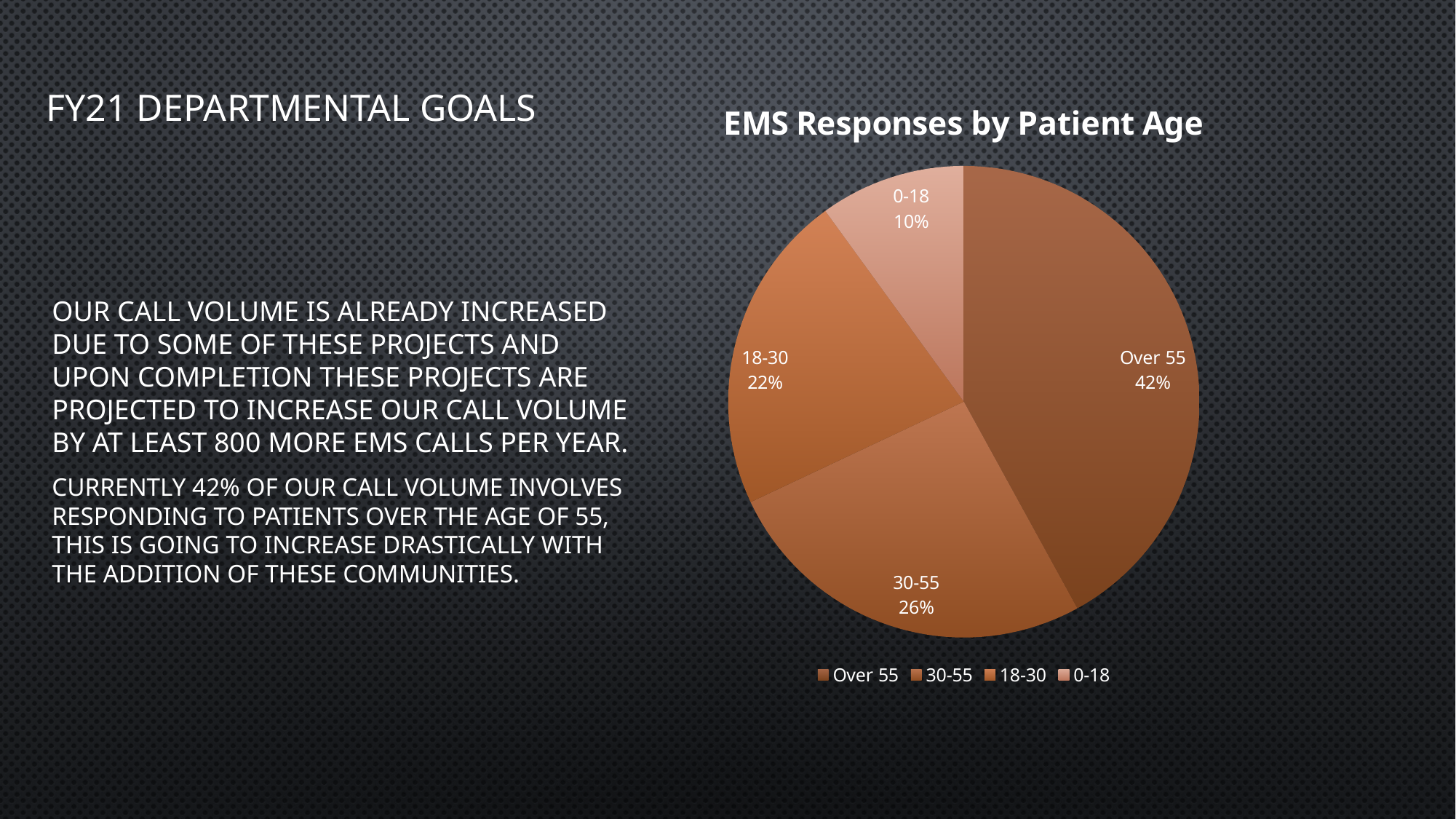
What type of chart is shown on the slide? Pie chart What is the title of the chart? EMS Responses by Patient Age What is the difference in percentage points between the Over 55 and 30-55 slices? 16 How many age groups are shown in the pie chart? 4 What percentage of EMS responses are for patients Over 55? 42% Which slice is larger, 30-55 or 18-30? 30-55 What percentage of EMS responses are for patients aged 0-18? 10% Which age group has the smallest share of EMS responses? 0-18 What percentage of EMS responses are for patients aged 30-55? 26% What percentage of EMS responses are for patients aged 18-30? 22% How many entries does the legend list? 4 Which age group has the largest share of EMS responses? Over 55